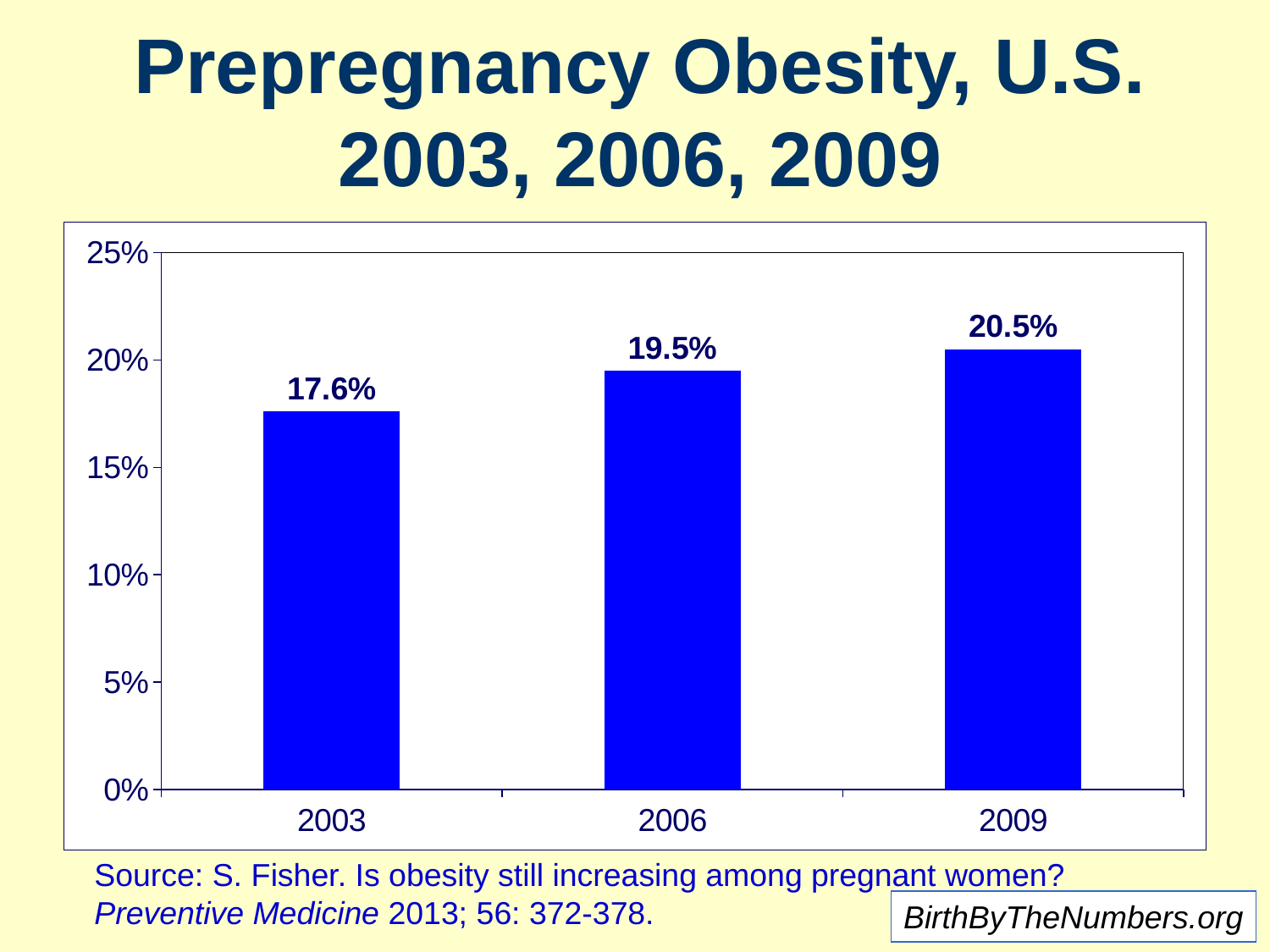
What is the difference between the 2009 and 2003 values? 2.9% What kind of chart is shown on the slide? bar chart What is the prepregnancy obesity value for 2009? 20.5% Is the value for 2003 greater or less than 20%? less What is the prepregnancy obesity value for 2006? 19.5% Do the values rise or fall from 2003 to 2009? rise Which is larger, the value for 2006 or the value for 2009? 2009 Which year has the highest prepregnancy obesity value? 2009 How many years are shown on the chart? 3 What is the prepregnancy obesity value for 2003? 17.6% What is the difference between the 2006 and 2003 values? 1.9% Which year has the lowest prepregnancy obesity value? 2003